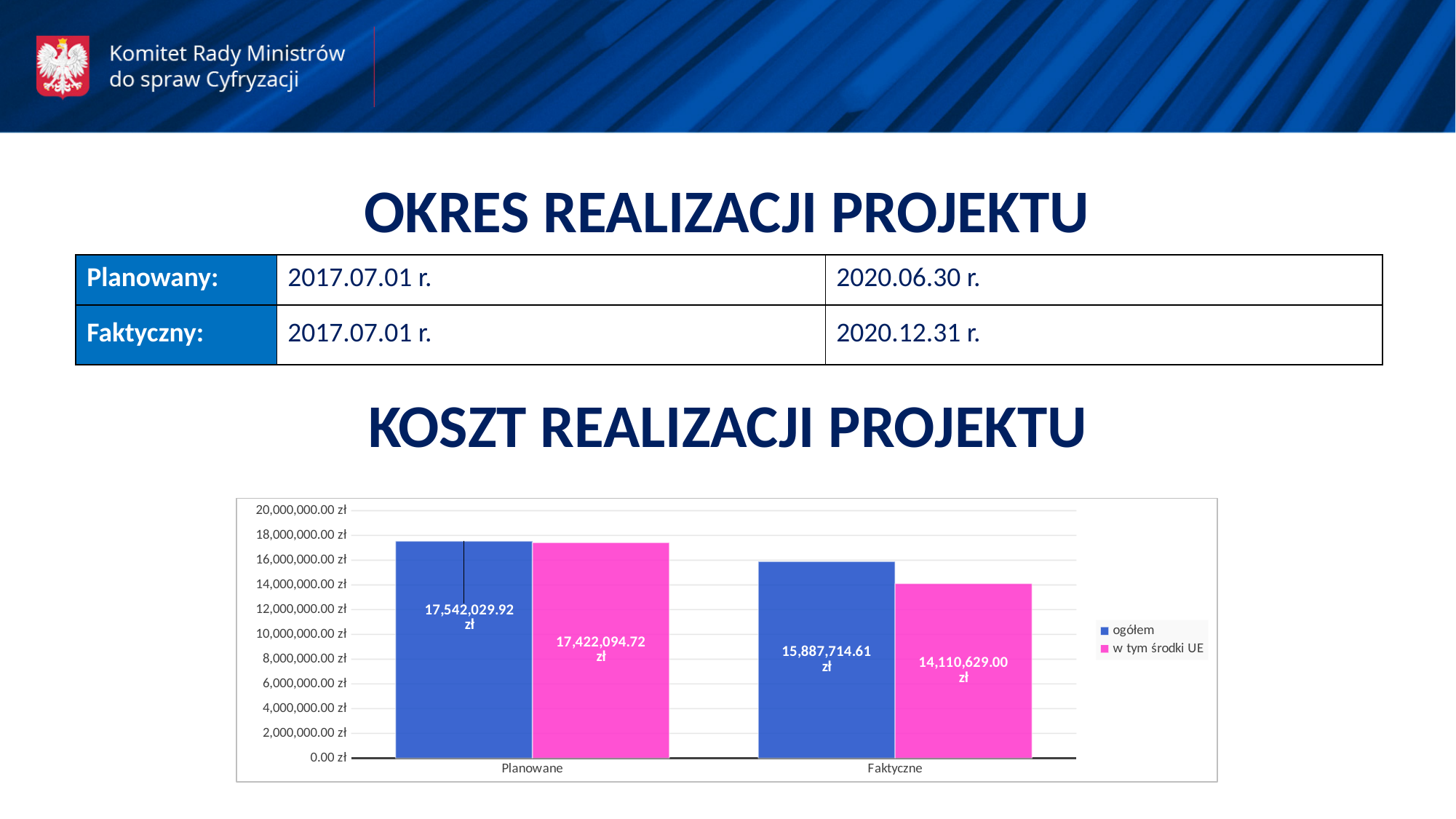
What is the value of the 'ogółem' bar for 'Faktyczne'? 15,887,714.61 zł Which is larger: the 'w tym środki UE' value for 'Planowane' or for 'Faktyczne'? Planowane Which bar in the chart has the highest value? ogółem for Planowane What is the value of the 'ogółem' bar for 'Planowane'? 17,542,029.92 zł What is the difference between the 'ogółem' and 'w tym środki UE' values for 'Faktyczne'? 1,777,085.61 zł How many categories are shown on the x axis of the chart? 2 Which bar in the chart has the lowest value? w tym środki UE for Faktyczne How many series does the chart legend list? 2 What is the value of the 'w tym środki UE' bar for 'Faktyczne'? 14,110,629.00 zł What type of chart is shown under 'KOSZT REALIZACJI PROJEKTU'? Bar chart What is the value of the 'w tym środki UE' bar for 'Planowane'? 17,422,094.72 zł What is the difference between the 'ogółem' values for 'Planowane' and 'Faktyczne'? 1,654,315.31 zł